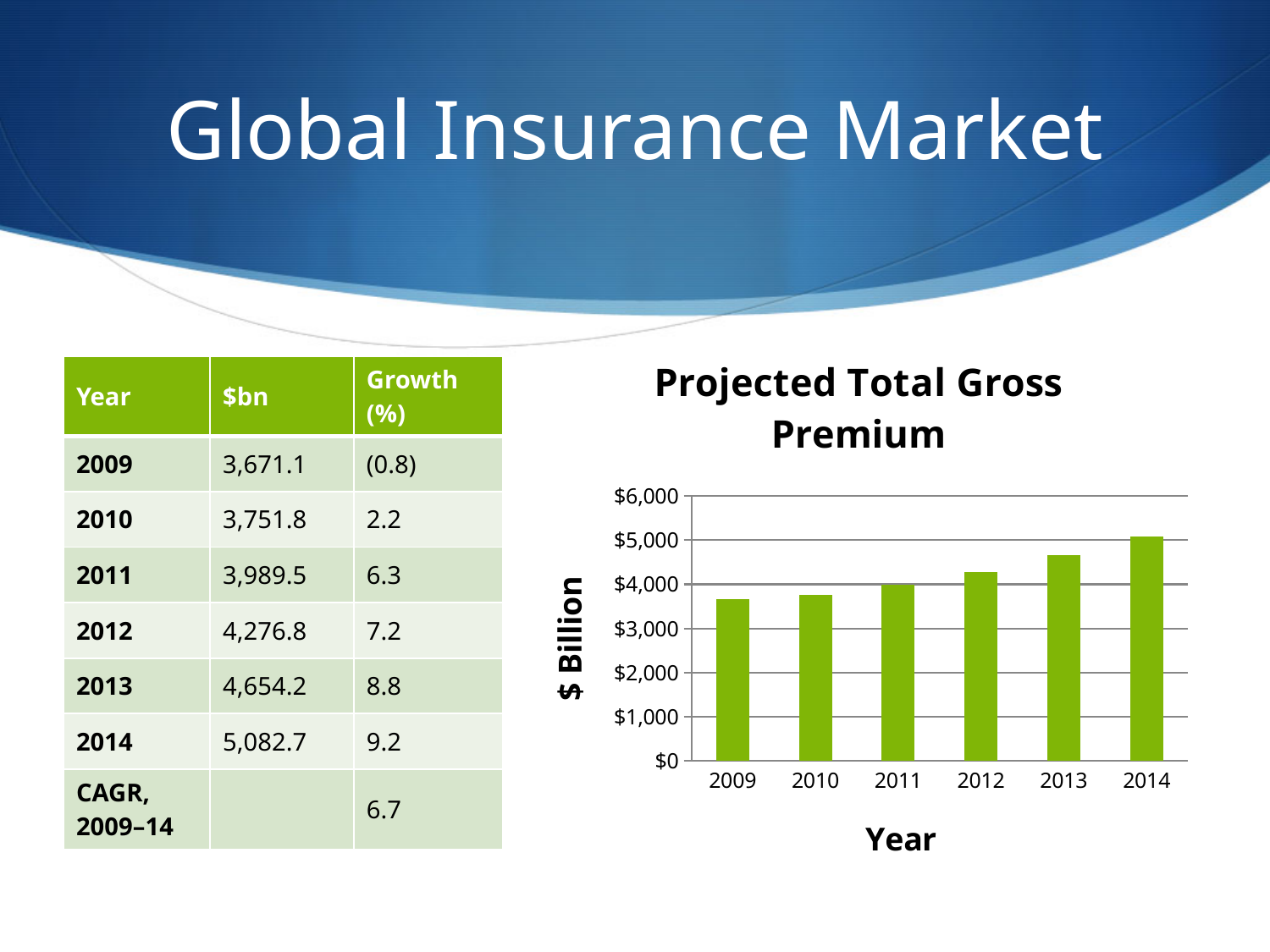
In the "Projected Total Gross Premium" chart, is the value for 2012 greater or less than $4,000? greater What is the label on the y axis of the "Projected Total Gross Premium" chart? $ Billion How many years are plotted on the x axis of the "Projected Total Gross Premium" chart? 6 What kind of chart is shown under the title "Projected Total Gross Premium"? bar chart In the "Projected Total Gross Premium" chart, is the value for 2013 greater or less than $5,000? less Which year has the highest bar in the "Projected Total Gross Premium" chart? 2014 In the "Projected Total Gross Premium" chart, is the value for 2009 greater or less than $4,000? less Which year has the lowest bar in the "Projected Total Gross Premium" chart? 2009 What is the label on the x axis of the "Projected Total Gross Premium" chart? Year Do the values in the "Projected Total Gross Premium" chart rise or fall from 2009 to 2014? rise In the "Projected Total Gross Premium" chart, which is larger, the value for 2011 or the value for 2013? 2013